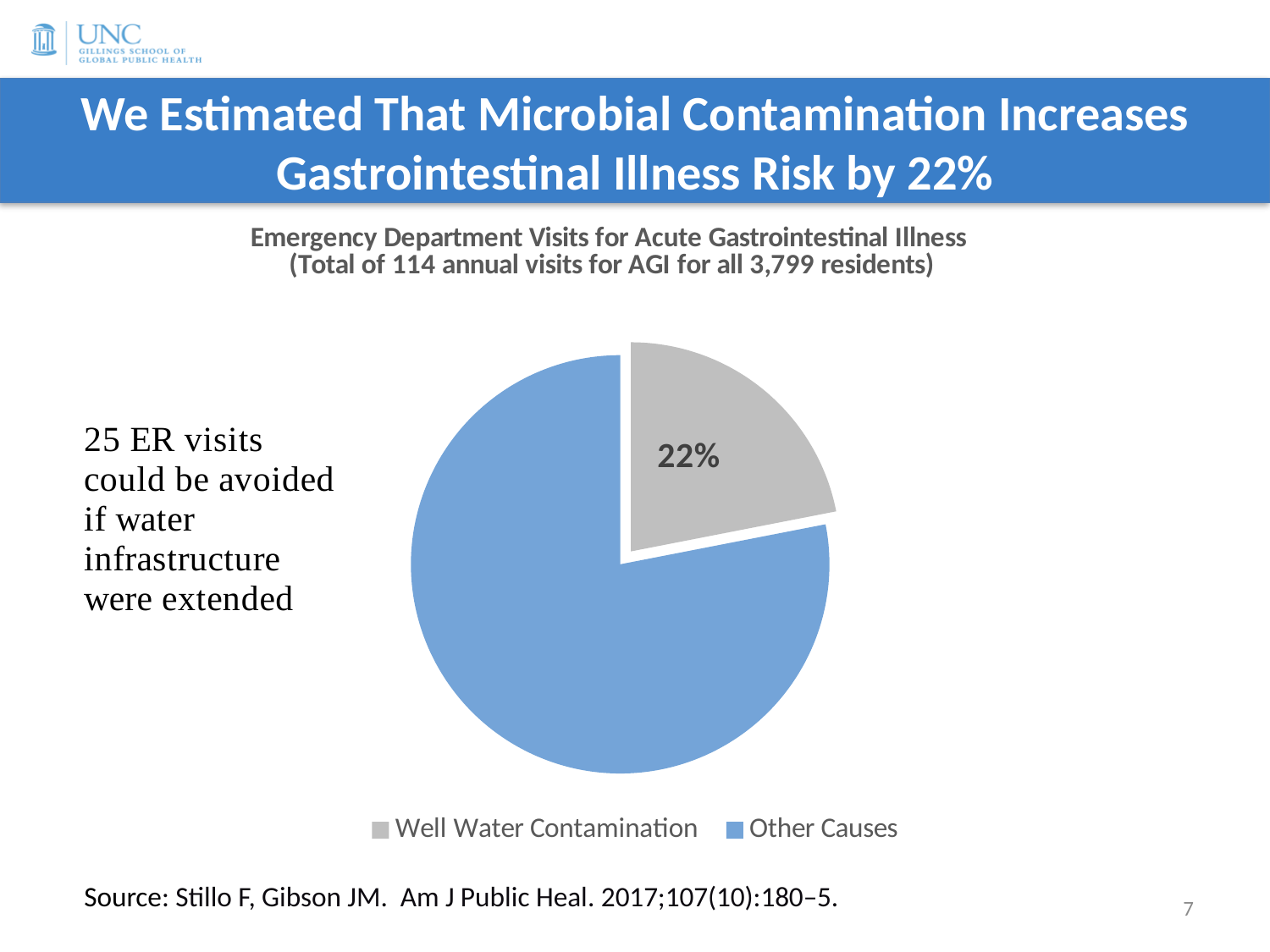
What kind of chart is shown on the slide? pie chart What percentage is shown for the Well Water Contamination slice? 22% Which slice of the pie chart is the smallest? Well Water Contamination What is the title of the pie chart? Emergency Department Visits for Acute Gastrointestinal Illness (Total of 114 annual visits for AGI for all 3,799 residents) Which is larger in the pie chart, Well Water Contamination or Other Causes? Other Causes What colour is the Other Causes slice in the pie chart? blue Which slice of the pie chart is the largest? Other Causes How many slices does the pie chart have? 2 How many entries does the legend of the pie chart list? 2 What share of the pie does Well Water Contamination account for? 22%